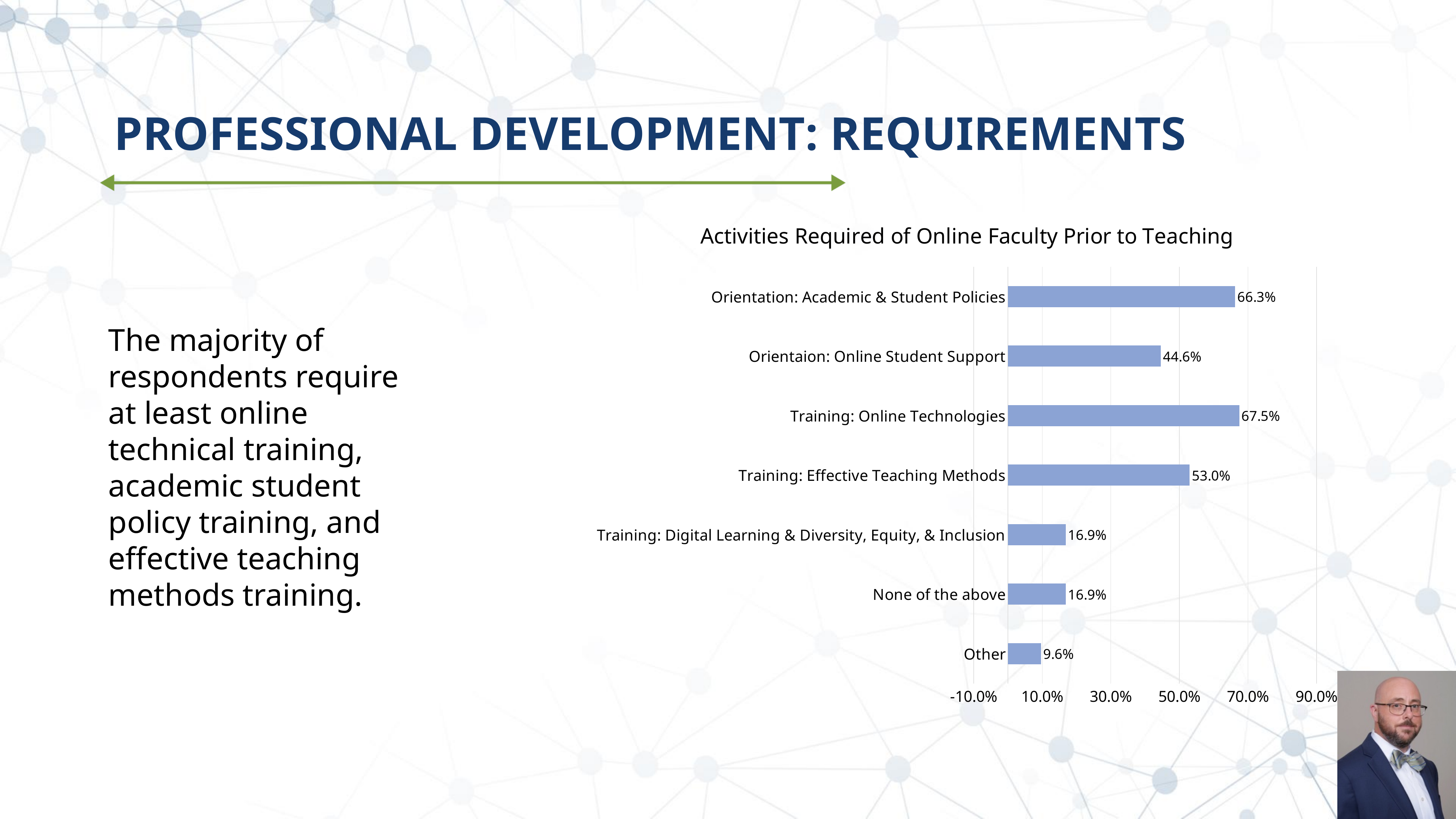
How many categories are shown in the chart? 7 What is the value for Orientation: Academic & Student Policies? 66.3% Which is larger, Training: Effective Teaching Methods or Orientaion: Online Student Support? Training: Effective Teaching Methods What kind of chart is shown? Bar chart Which category has the highest value? Training: Online Technologies What is the value for Training: Online Technologies? 67.5% What is the difference between Training: Online Technologies and Orientaion: Online Student Support? 22.9% What is the value for Other? 9.6% Which category has the lowest value? Other What is the value for Training: Effective Teaching Methods? 53.0% What is the difference between Training: Digital Learning & Diversity, Equity, & Inclusion and Other? 7.3% What is the title of the chart? Activities Required of Online Faculty Prior to Teaching